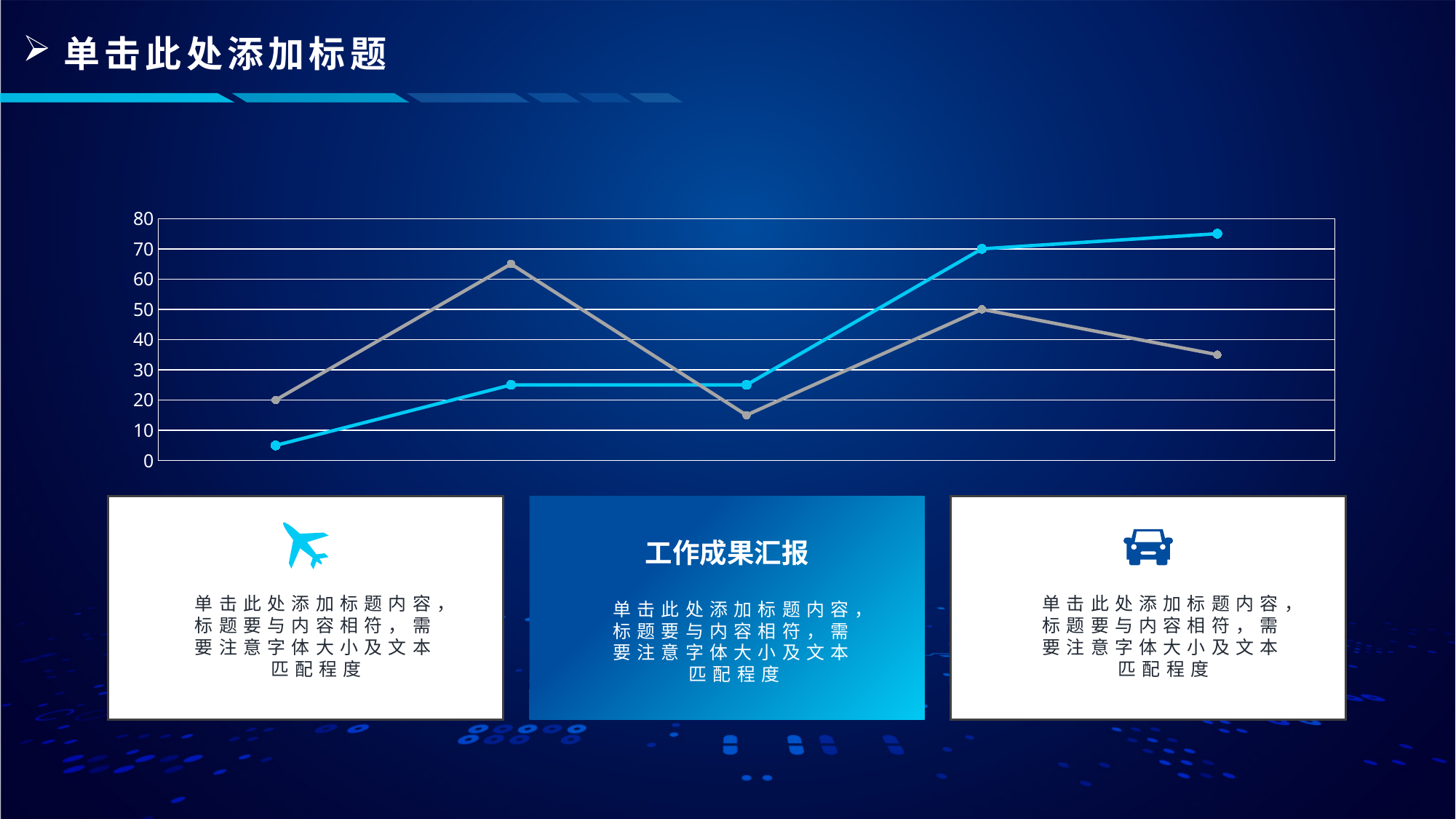
What is the difference between the cyan line and the gray line at the fourth point? 20 Is the value of the first point on the cyan line greater or less than 10? less How many lines (series) are plotted in the chart? 2 What kind of chart is shown on the slide? line chart What is the value of the fourth point on the gray line? 50 Is the value of the third point on the gray line greater or less than 20? less Which point on the gray line has the highest value? the second point Is the value of the last point on the cyan line greater or less than 70? greater What is the value of the first point on the gray line? 20 At the fourth point, which line has the larger value, the cyan line or the gray line? the cyan line How many data points does each line in the chart have? 5 What is the value of the fourth point on the cyan line? 70